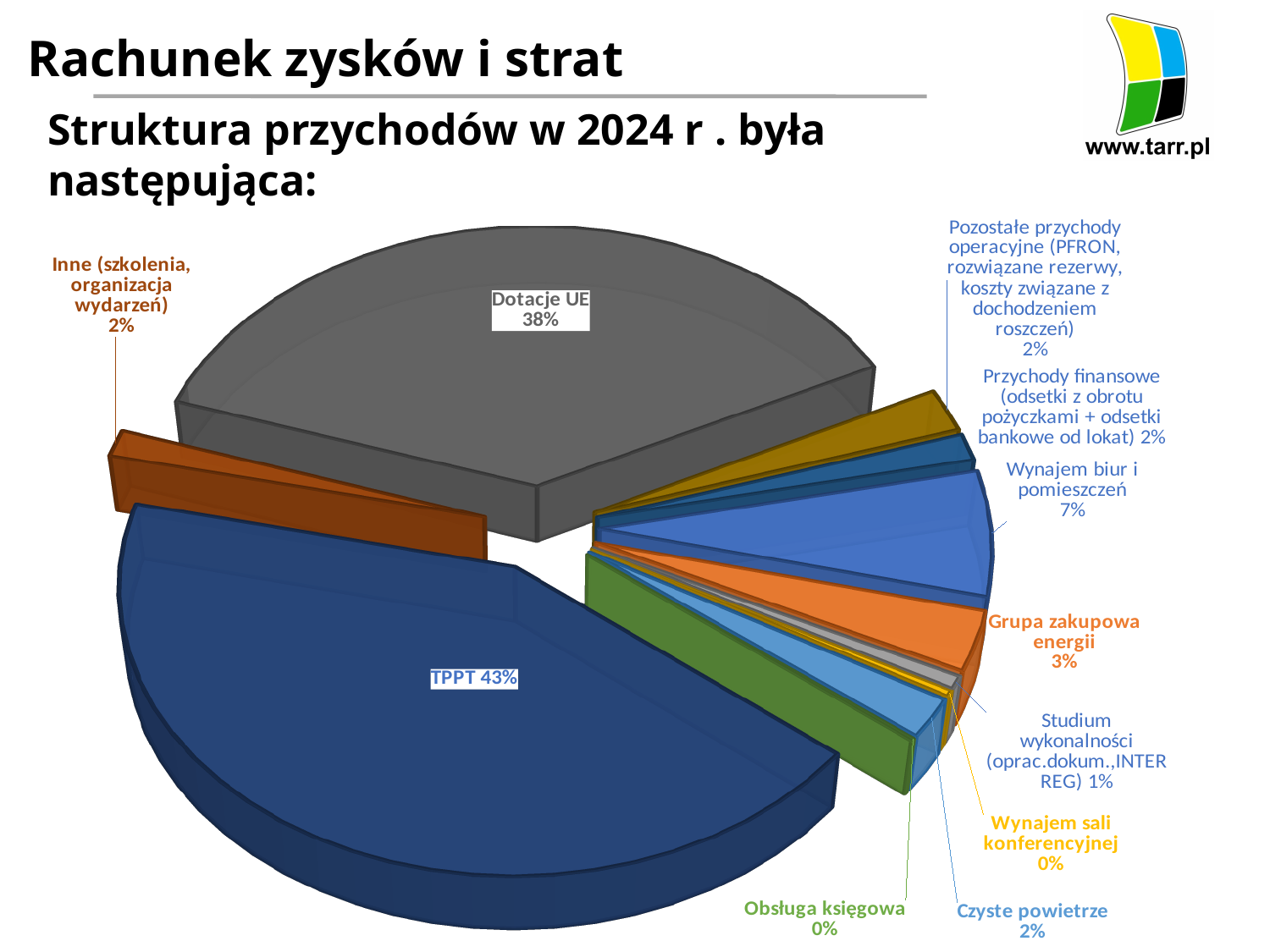
Which year does the revenue structure shown in the chart refer to? 2024 What kind of chart is shown on the slide? pie chart What share of revenue does Studium wykonalności (oprac.dokum., INTERREG) account for? 1% What is the difference in percentage points between TPPT and Dotacje UE? 5 What share of revenue does Wynajem biur i pomieszczeń account for? 7% How many slices does the pie chart have? 11 Which is larger, the share for Wynajem biur i pomieszczeń or the share for Grupa zakupowa energii? Wynajem biur i pomieszczeń What share of revenue does TPPT account for? 43% What share of revenue does Czyste powietrze account for? 2% Which category has the largest share of the pie? TPPT What share of revenue does Grupa zakupowa energii account for? 3% What share of revenue does Dotacje UE account for? 38%